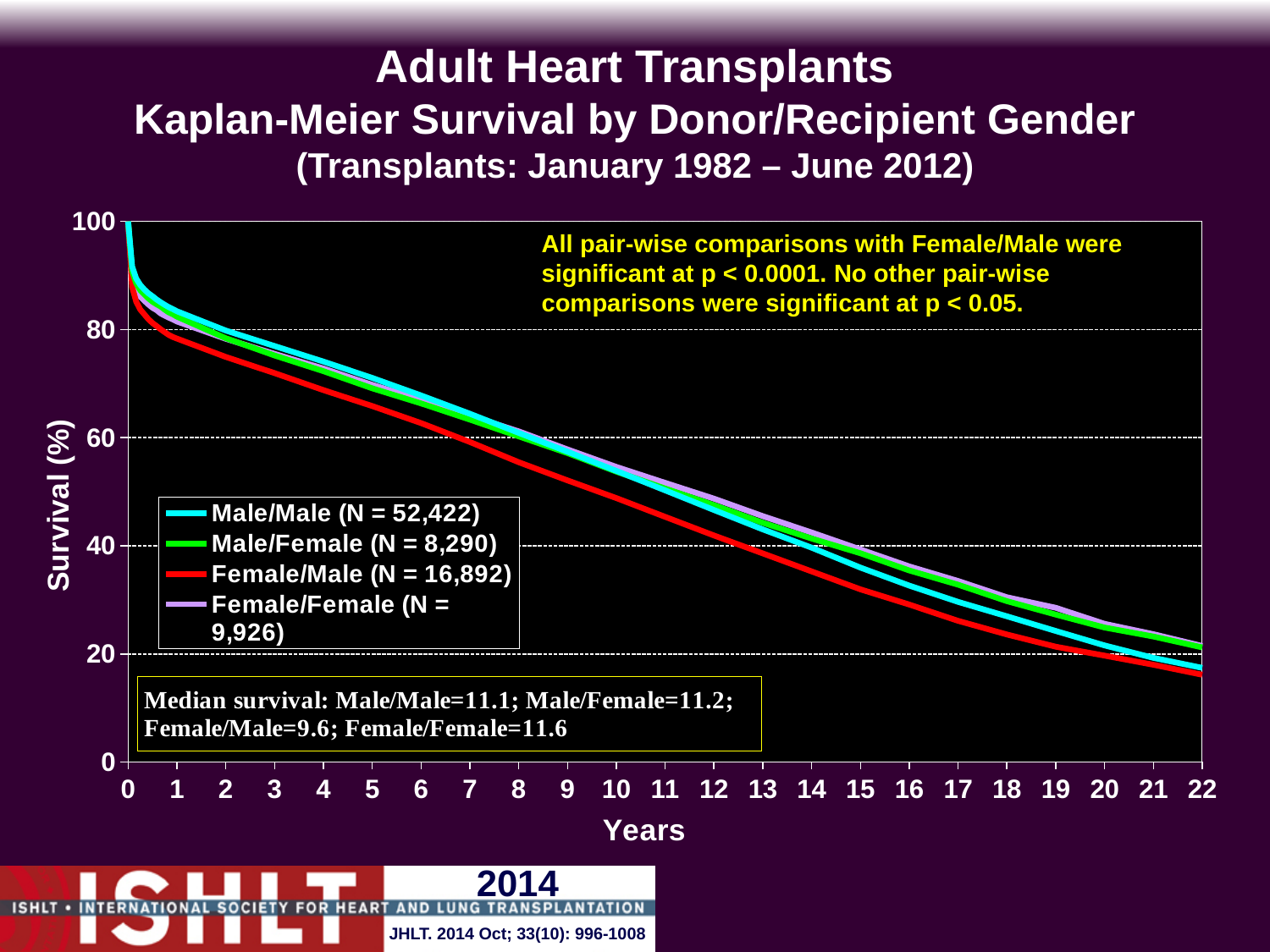
What is the median survival for the Female/Male group? 9.6 What is the difference in median survival between the Female/Female and Female/Male groups? 2.0 What is the median survival for the Male/Male group? 11.1 Which donor/recipient gender group has the highest median survival? Female/Female Is the survival for the Female/Male group at year 5 greater or less than 60? greater Do the survival curves rise or fall as years increase? fall At year 20, which group has higher survival, Male/Female or Female/Male? Male/Female What kind of chart is shown on the slide? line chart Which donor/recipient gender group has the lowest median survival? Female/Male How many series does the legend list? 4 What is the median survival for the Female/Female group? 11.6 Is the survival for the Female/Male group at year 22 greater or less than 20? less